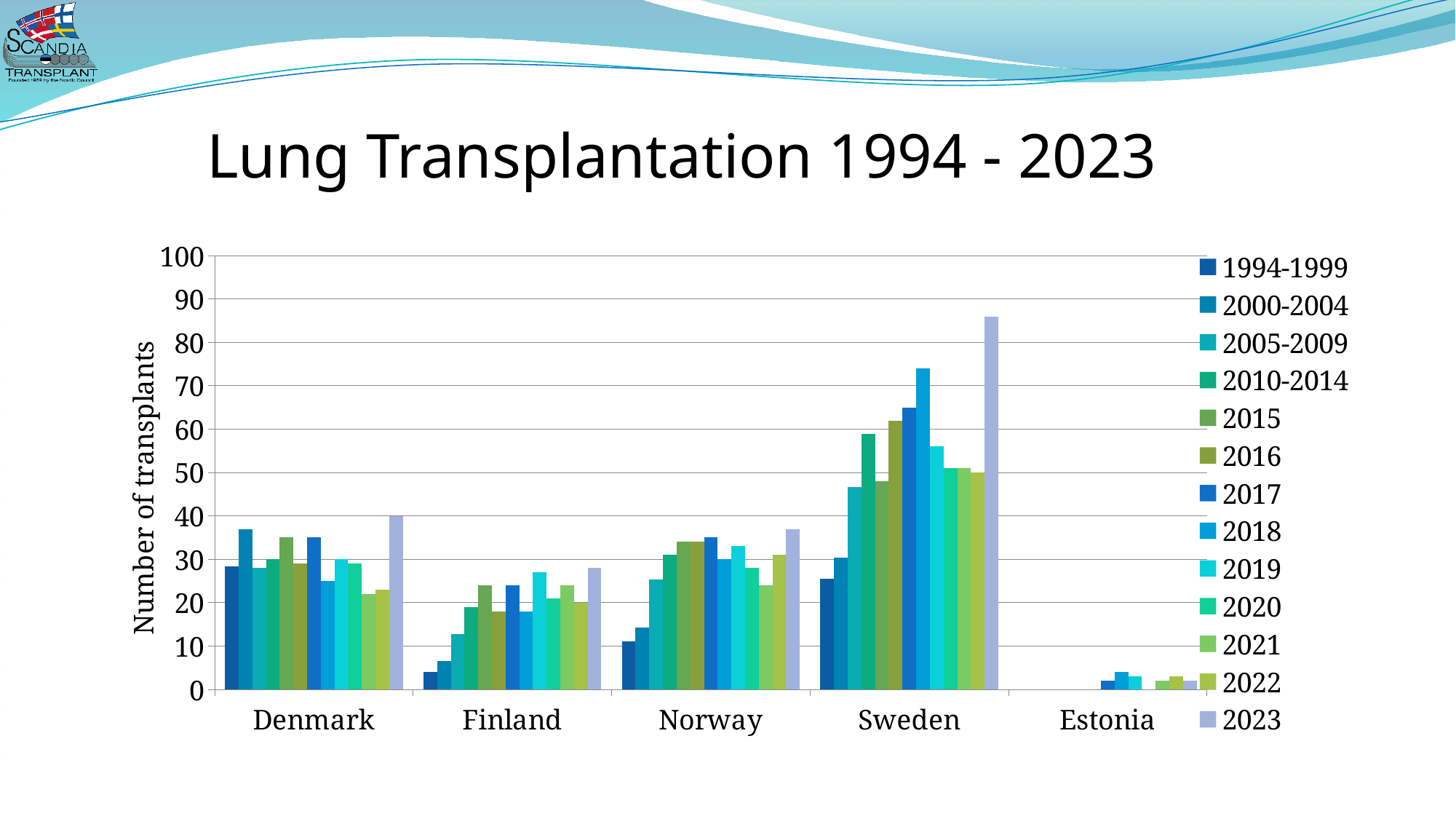
Which is larger, the 2023 value for Sweden or the 2023 value for Denmark? Sweden Which country has the highest bar in the chart? Sweden Is the value for Norway in 1994-1999 greater or less than 20? less For Sweden, which period has the highest number of transplants? 2023 Which country has the lowest bars in the chart? Estonia Is the value for Sweden in 2023 greater or less than 80? greater Is the value for Finland in 1994-1999 greater or less than 10? less What kind of chart is shown on the slide? bar chart What is the label of the y axis? Number of transplants How many series does the legend list? 13 How many countries are shown on the x axis of the chart? 5